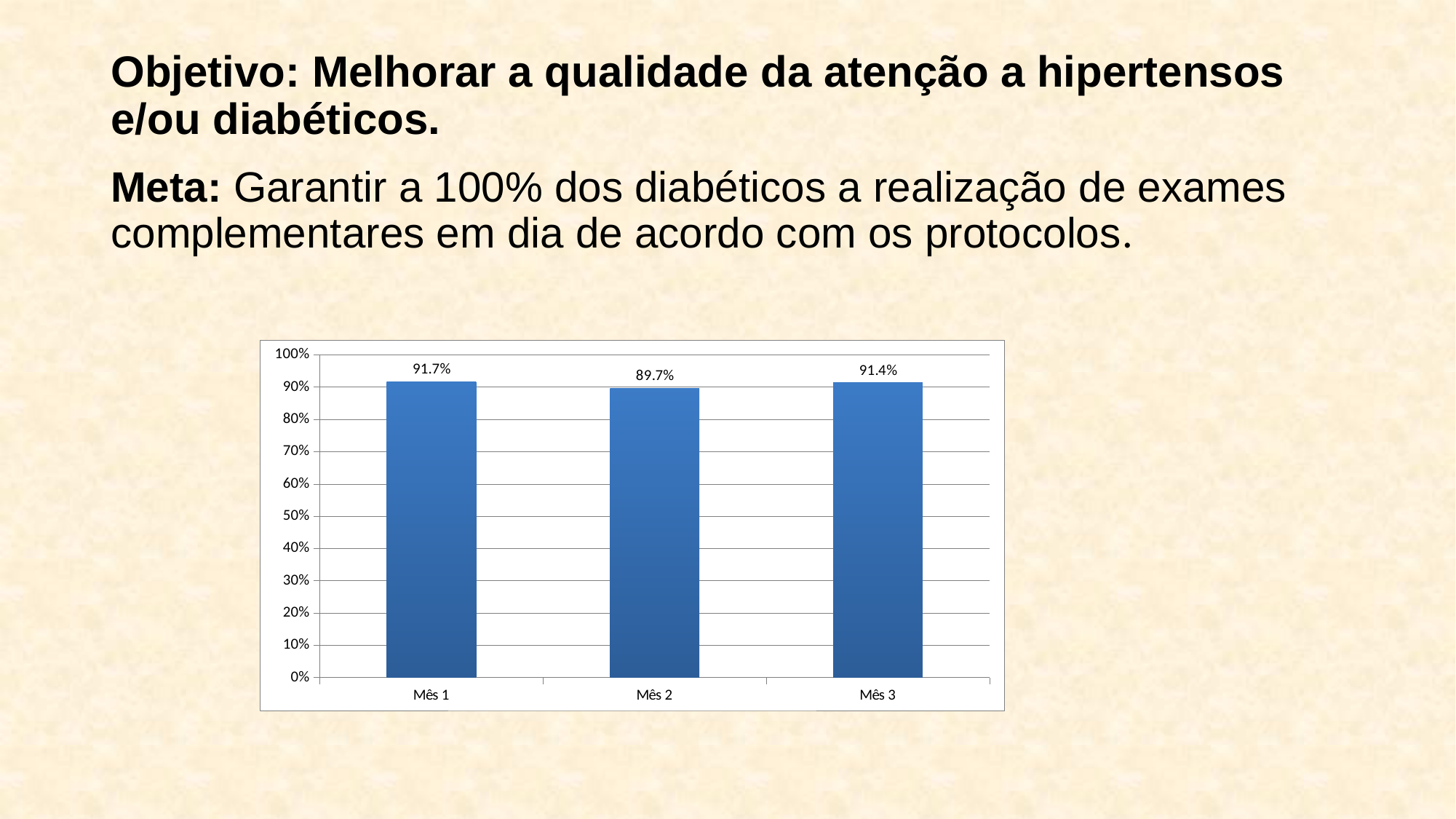
Which is larger, the value for Mês 2 or the value for Mês 3? Mês 3 What is the difference between the values for Mês 1 and Mês 2? 2.0% What is the value for Mês 1? 91.7% Is the value for Mês 2 greater or less than 90%? less What kind of chart is shown on the slide? bar chart What is the value for Mês 2? 89.7% How many months are shown on the chart? 3 What is the value for Mês 3? 91.4% What is the difference between the values for Mês 3 and Mês 2? 1.7% What is the highest value shown on the vertical axis? 100% Which month has the lowest value? Mês 2 Which month has the highest value? Mês 1